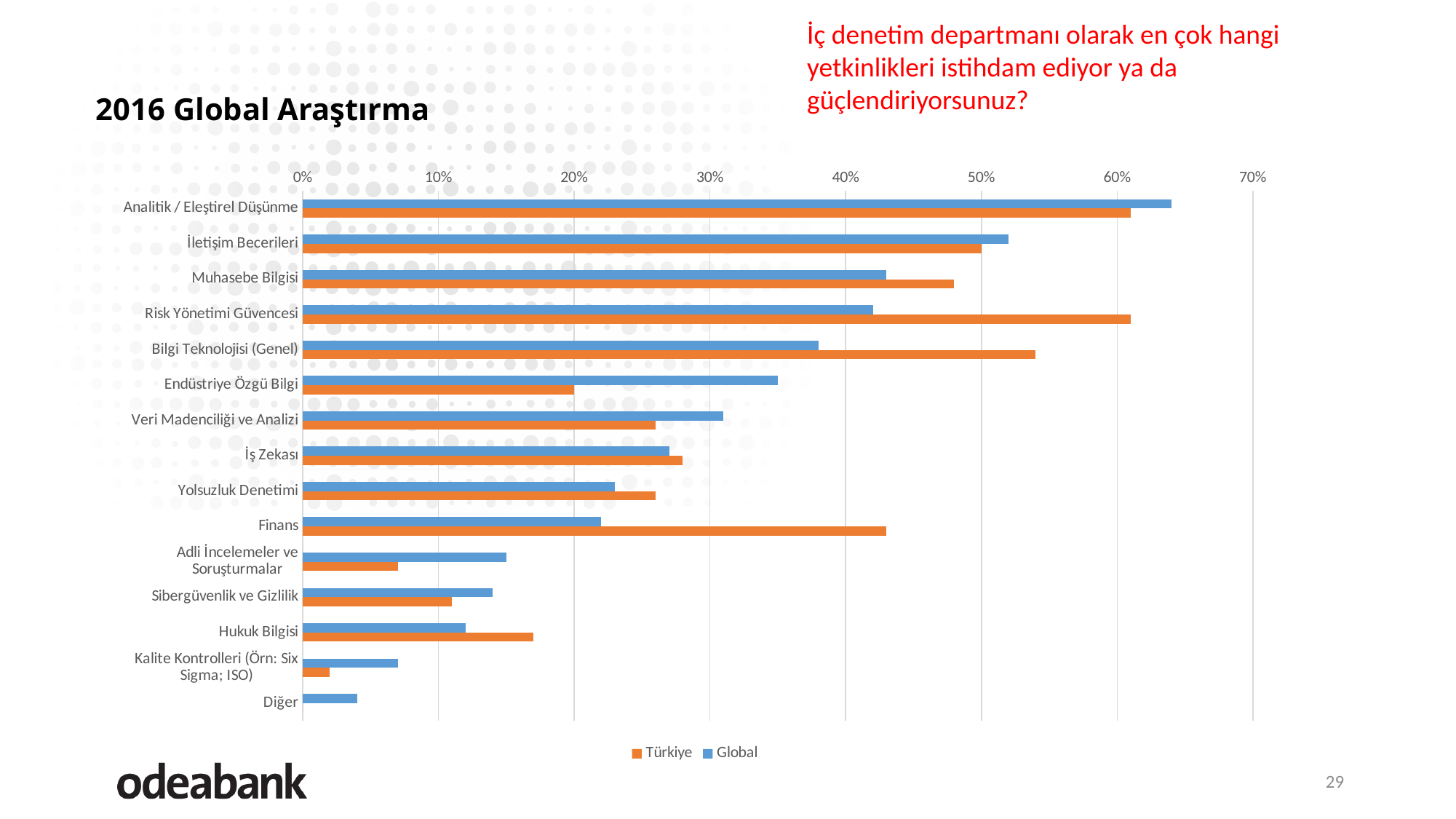
Is the Türkiye value for Finans greater or less than 40%? greater How many series does the legend list? 2 Which colour represents the Türkiye series in the legend? orange What kind of chart is shown on the slide? bar chart How many categories are shown on the chart? 15 For Endüstriye Özgü Bilgi, which series has the larger value, Türkiye or Global? Global For Risk Yönetimi Güvencesi, which series has the larger value, Türkiye or Global? Türkiye Which category has the highest Global value? Analitik / Eleştirel Düşünme Is the Global value for Analitik / Eleştirel Düşünme greater or less than 60%? greater Is the Global value for Endüstriye Özgü Bilgi greater or less than 30%? greater Which category has the lowest Global value? Diğer